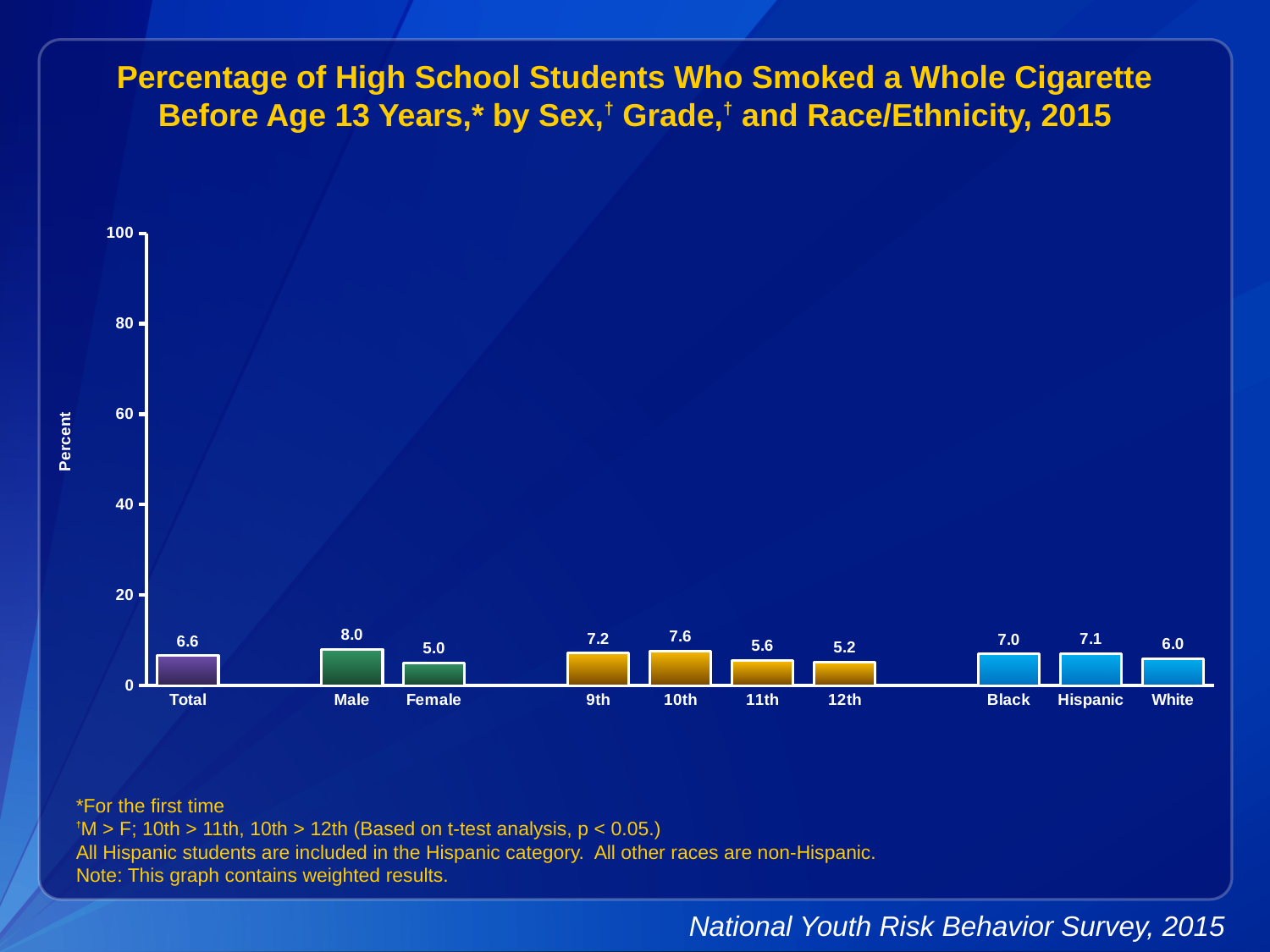
Which category has the lowest value? Female What is the value for Male? 8.0 What is the difference between the values for Male and Female? 3.0 Which is larger, the value for Black or the value for White? Black Which category has the highest value? Male What is the value for Hispanic? 7.1 What is the label on the y axis? Percent What kind of chart is this? Bar chart What is the value for 12th grade? 5.2 What is the difference between the values for 10th and 11th grade? 2.0 How many categories are shown on the x axis? 10 What is the value for Total? 6.6